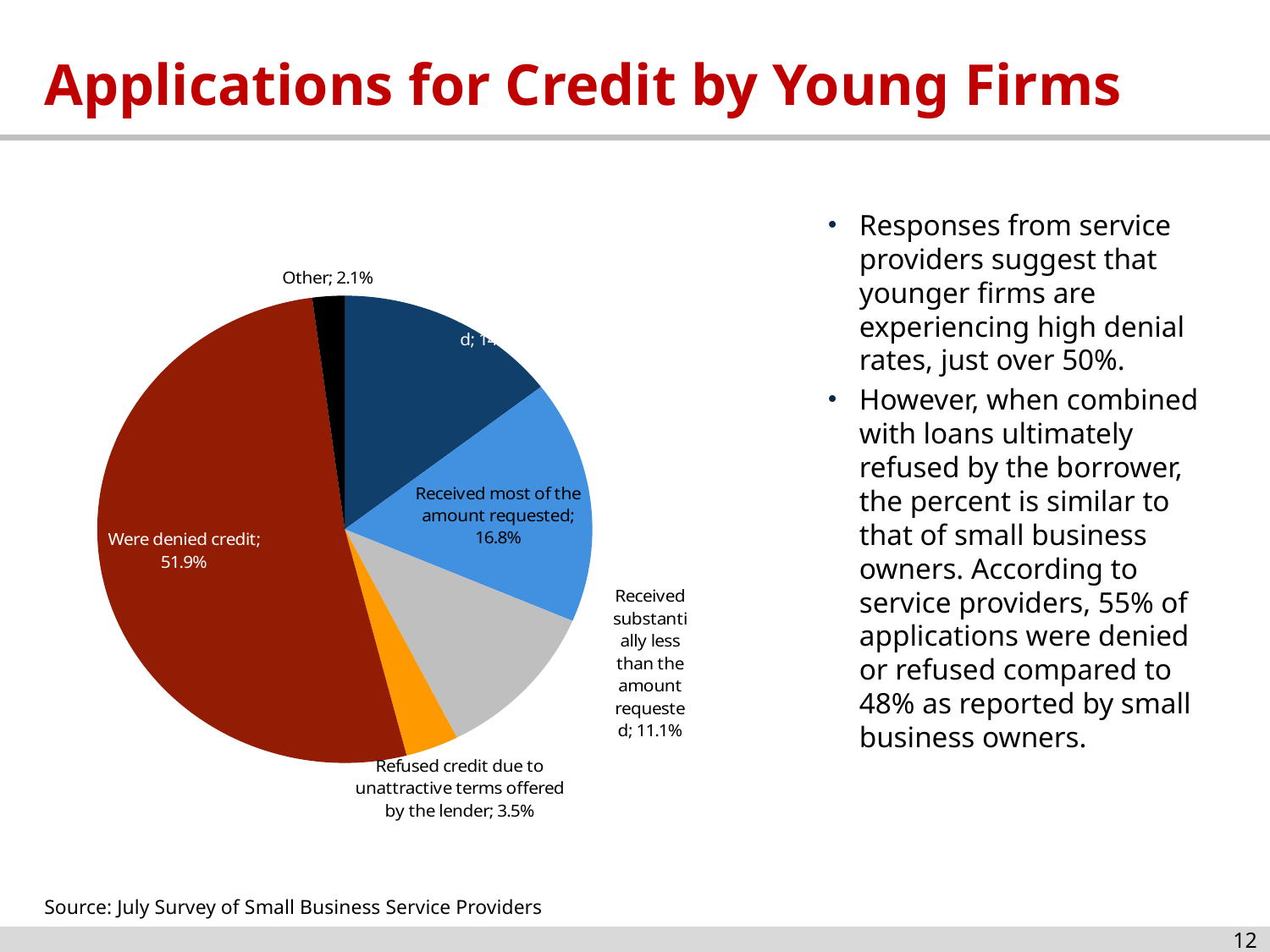
How many slices does the pie chart have? 6 Which is larger: 'Received most of the amount requested' or 'Received substantially less than the amount requested'? Received most of the amount requested What is the source cited for the chart? July Survey of Small Business Service Providers What is the value of the 'Other' slice? 2.1% Which labelled category has the smallest share of the pie? Other Which category has the largest share of the pie? Were denied credit What kind of chart is shown on the slide? Pie chart What percentage refused credit due to unattractive terms offered by the lender? 3.5% What share of the pie is labelled 'Received most of the amount requested'? 16.8% What is the difference between the 'Were denied credit' share and the 'Received most of the amount requested' share? 35.1 percentage points What percentage received substantially less than the amount requested? 11.1% What percentage of young firms were denied credit? 51.9%